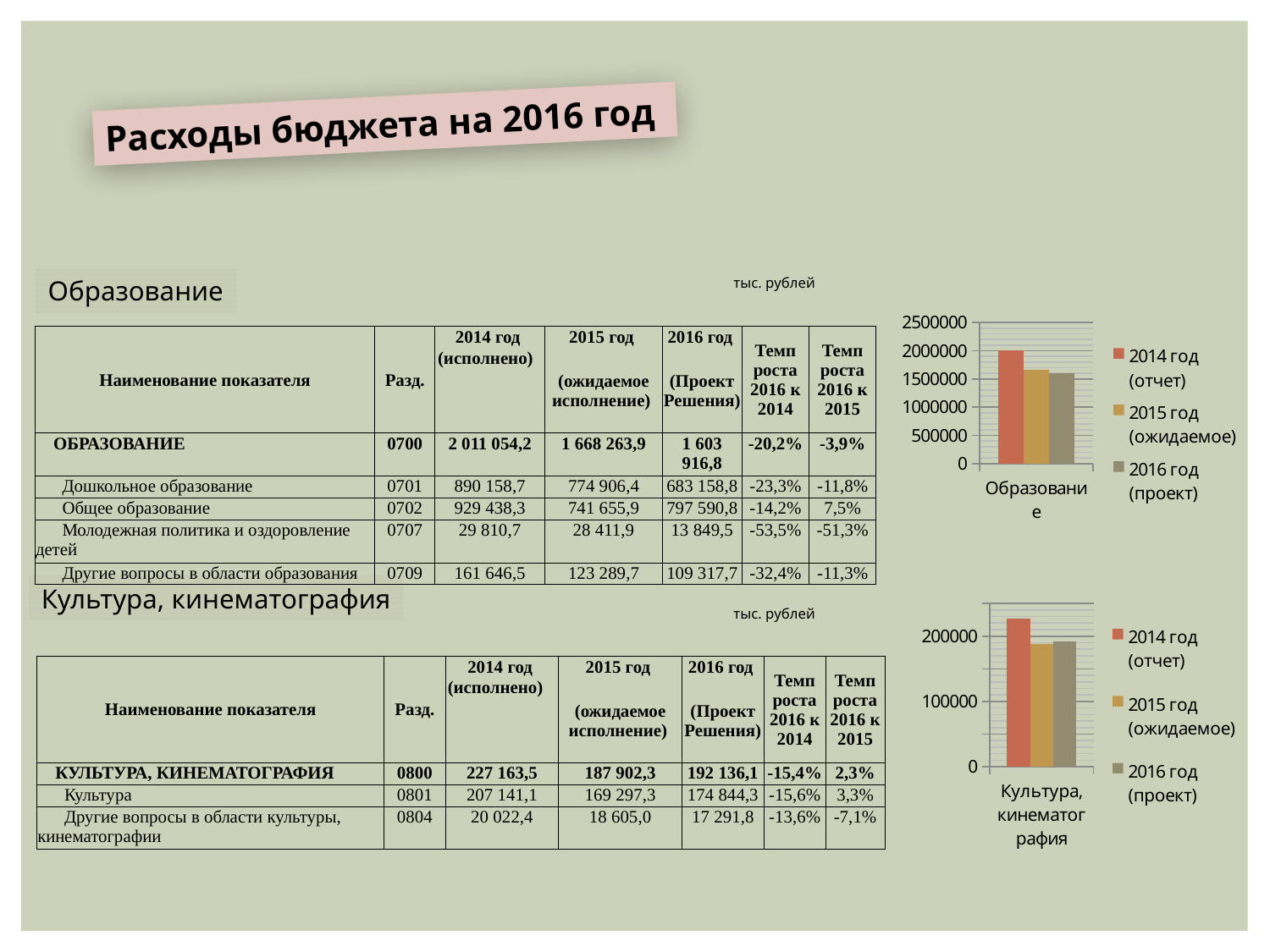
What kind of chart is the bottom-right chart on the slide (the one with the category 'Культура, кинематография')? bar chart In the bottom-right chart (category 'Культура, кинематография'), is the value for 2014 год (отчет) greater or less than 200000? greater What kind of chart is the top-right chart on the slide (the one with the category 'Образование')? bar chart In the bottom-right chart (category 'Культура, кинематография'), is the value for 2015 год (ожидаемое) greater or less than 200000? less In the bottom-right chart (category 'Культура, кинематография'), which series has the tallest bar? 2014 год (отчет) In the top-right chart (category 'Образование'), which is larger: the bar for 2014 год (отчет) or the bar for 2015 год (ожидаемое)? 2014 год (отчет) In the top-right chart (category 'Образование'), is the value for 2014 год (отчет) greater or less than 1500000? greater How many categories are shown on the x axis of the top-right chart (category 'Образование')? 1 What is the highest value shown on the y axis of the top-right chart (category 'Образование')? 2500000 In the top-right chart (category 'Образование'), which series has the tallest bar? 2014 год (отчет) How many series does the legend of the top-right chart (category 'Образование') list? 3